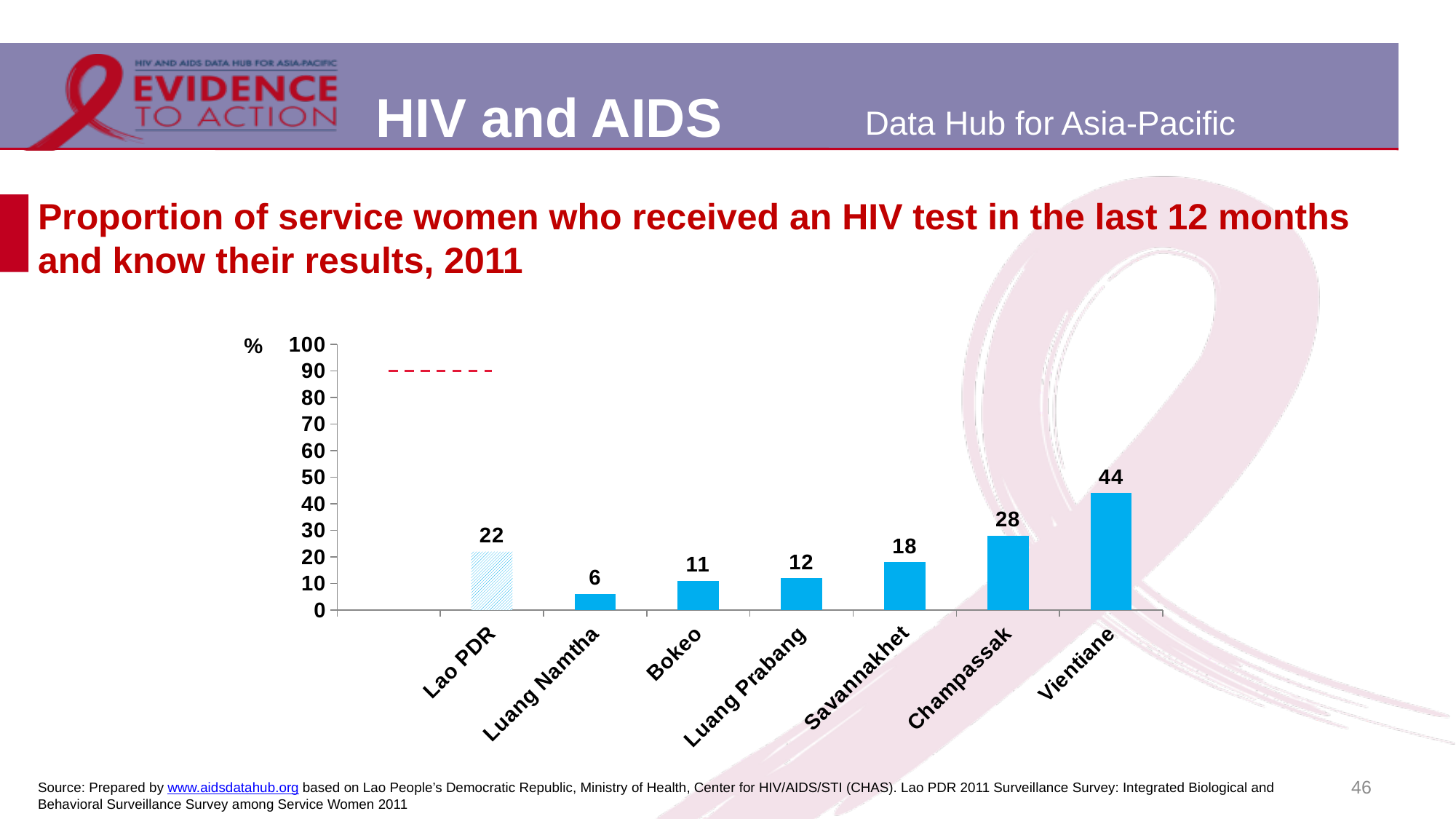
How many categories are shown on the x axis? 7 What kind of chart is shown on the slide? bar chart Which category has the highest value? Vientiane What is the value for Savannakhet? 18 What is the difference between the values for Vientiane and Champassak? 16 What is the value for Vientiane? 44 What is the unit label shown next to the y axis? % Which is larger, the value for Bokeo or the value for Luang Prabang? Luang Prabang What is the value for Luang Namtha? 6 Which category has the lowest value? Luang Namtha Is the value for Champassak greater or less than 20? greater What is the value for Lao PDR? 22